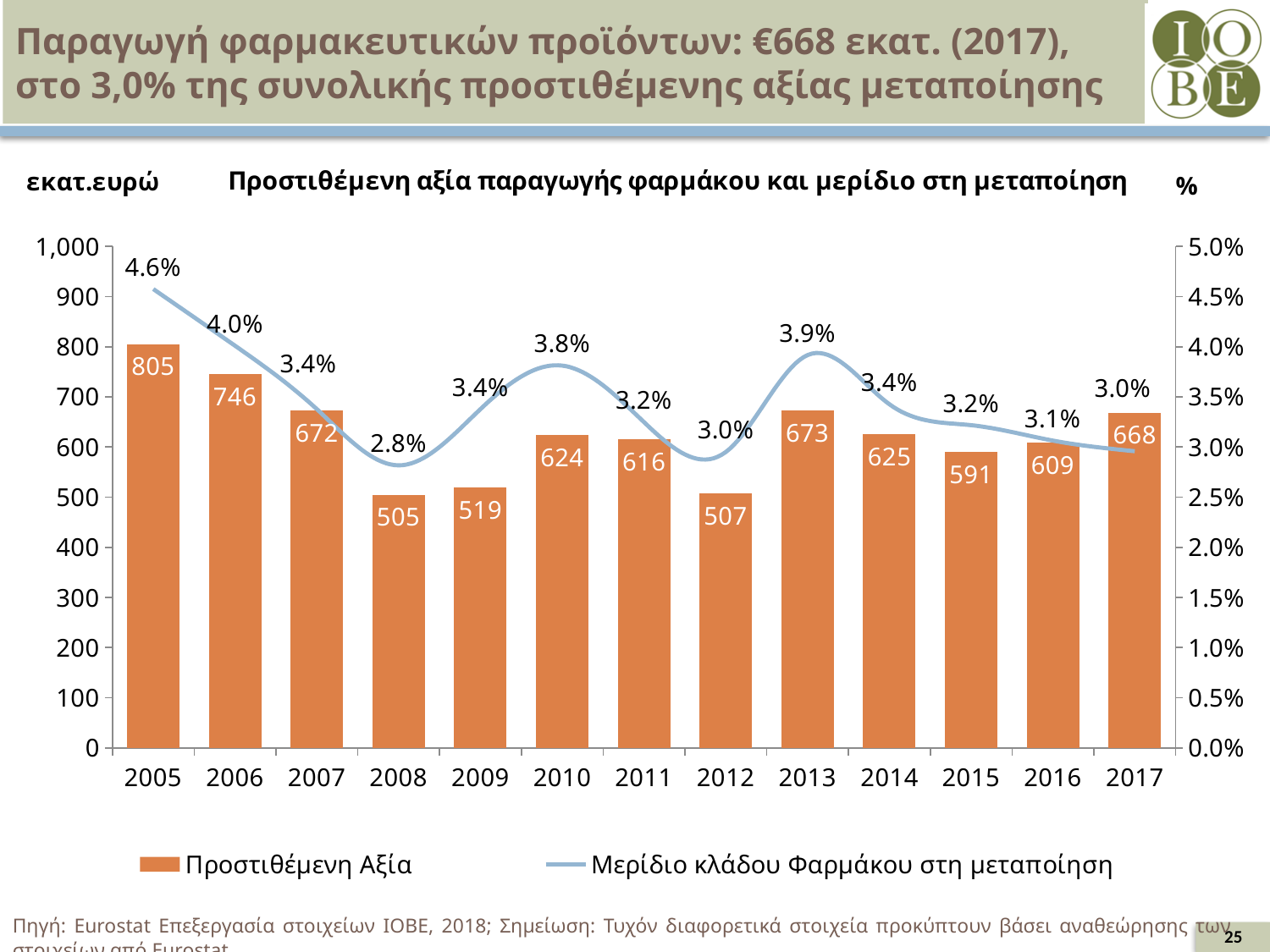
What is the Μερίδιο κλάδου Φαρμάκου στη μεταποίηση (share) for 2005? 4.6% What is the value of Προστιθέμενη Αξία for 2012? 507 Which year has the larger Προστιθέμενη Αξία, 2013 or 2014? 2013 Does the Μερίδιο κλάδου Φαρμάκου στη μεταποίηση rise or fall from 2005 to 2008? Fall How many years are shown on the x axis? 13 Which year has the highest Προστιθέμενη Αξία? 2005 What kind of chart is this? Combined bar and line chart Which year has the lowest Μερίδιο κλάδου Φαρμάκου στη μεταποίηση? 2008 What is the title of the chart? Προστιθέμενη αξία παραγωγής φαρμάκου και μερίδιο στη μεταποίηση How many series does the legend list? 2 What is the value of Προστιθέμενη Αξία (added value) for 2017? 668 What is the difference in Προστιθέμενη Αξία between 2005 and 2008? 300